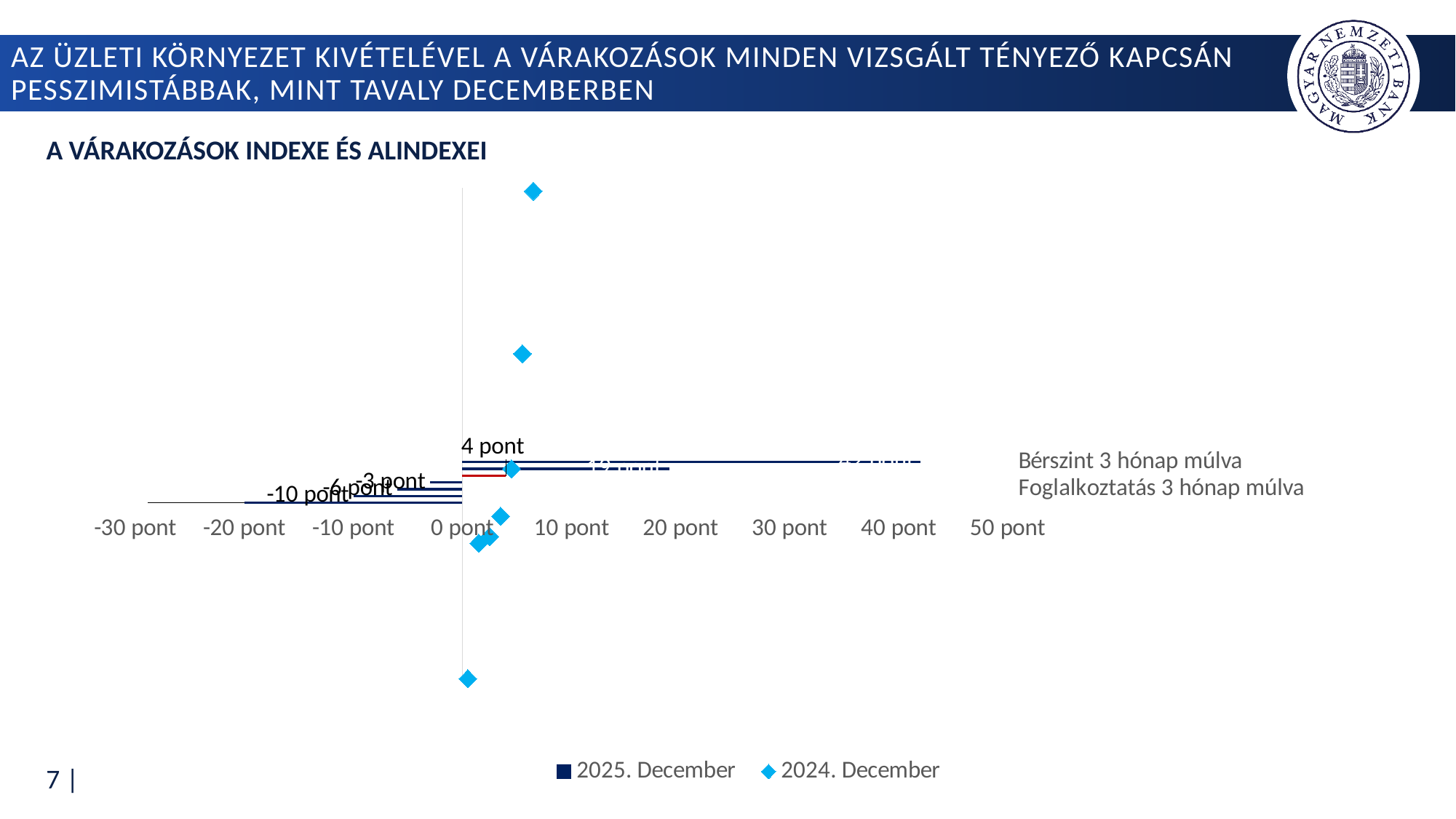
Which series in the legend is shown with diamond markers? 2024. December Is the value of the longest bar extending to the right greater or less than 30 pont? greater What is the title of the chart on the slide? A VÁRAKOZÁSOK INDEXE ÉS ALINDEXEI What is the difference between the bar labelled 4 pont and the bar labelled -10 pont? 14 pont What is the lowest value shown on the chart's x axis? -30 pont What kind of chart is shown on the slide? bar chart Is the value of the bar labelled -10 pont greater or less than 0 pont? less Which is larger, the bar labelled -3 pont or the bar labelled -6 pont? -3 pont How many series does the chart legend list? 2